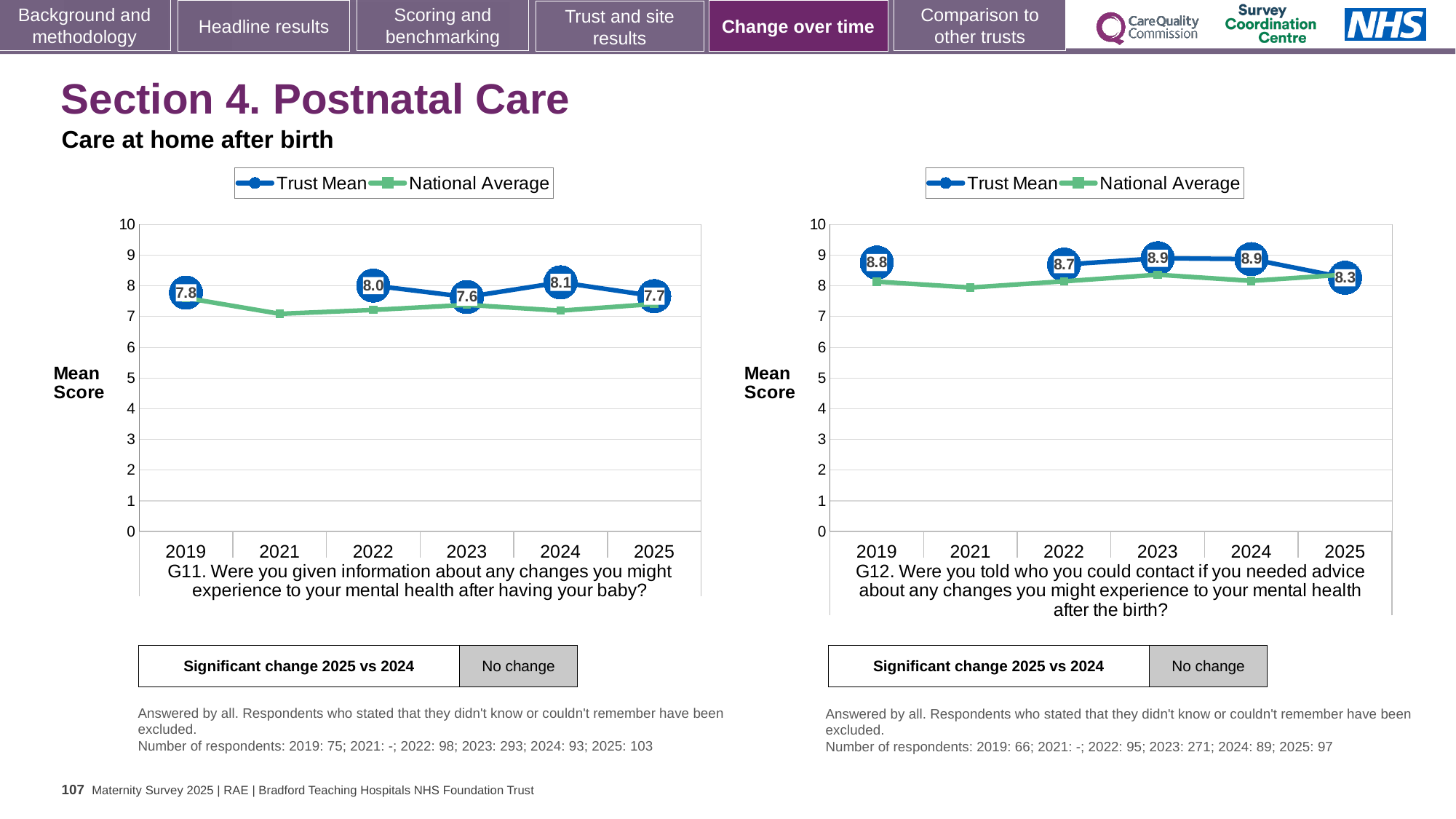
In the G12 chart on the right, what is the difference between the Trust Mean in 2019 and in 2025? 0.5 How many series does the legend of the G11 chart on the left list? 2 What type of chart is the G12 chart on the right? Line chart In the G11 chart on the left, is the National Average for 2021 greater or less than 8? less In the G12 chart on the right, which year has the lowest Trust Mean? 2025 How many years are shown on the x axis of the G12 chart on the right? 6 In the G12 chart on the right, is the National Average for 2023 greater or less than 8? greater In the G11 chart on the left, is the Trust Mean higher in 2022 or in 2023? 2022 In the G11 chart on the left, what is the difference between the Trust Mean in 2024 and in 2025? 0.4 In the G12 chart on the right, what is the Trust Mean for 2025? 8.3 In the G11 chart on the left, which year has the lowest Trust Mean? 2023 In the G11 chart on the left, what is the Trust Mean for 2024? 8.1